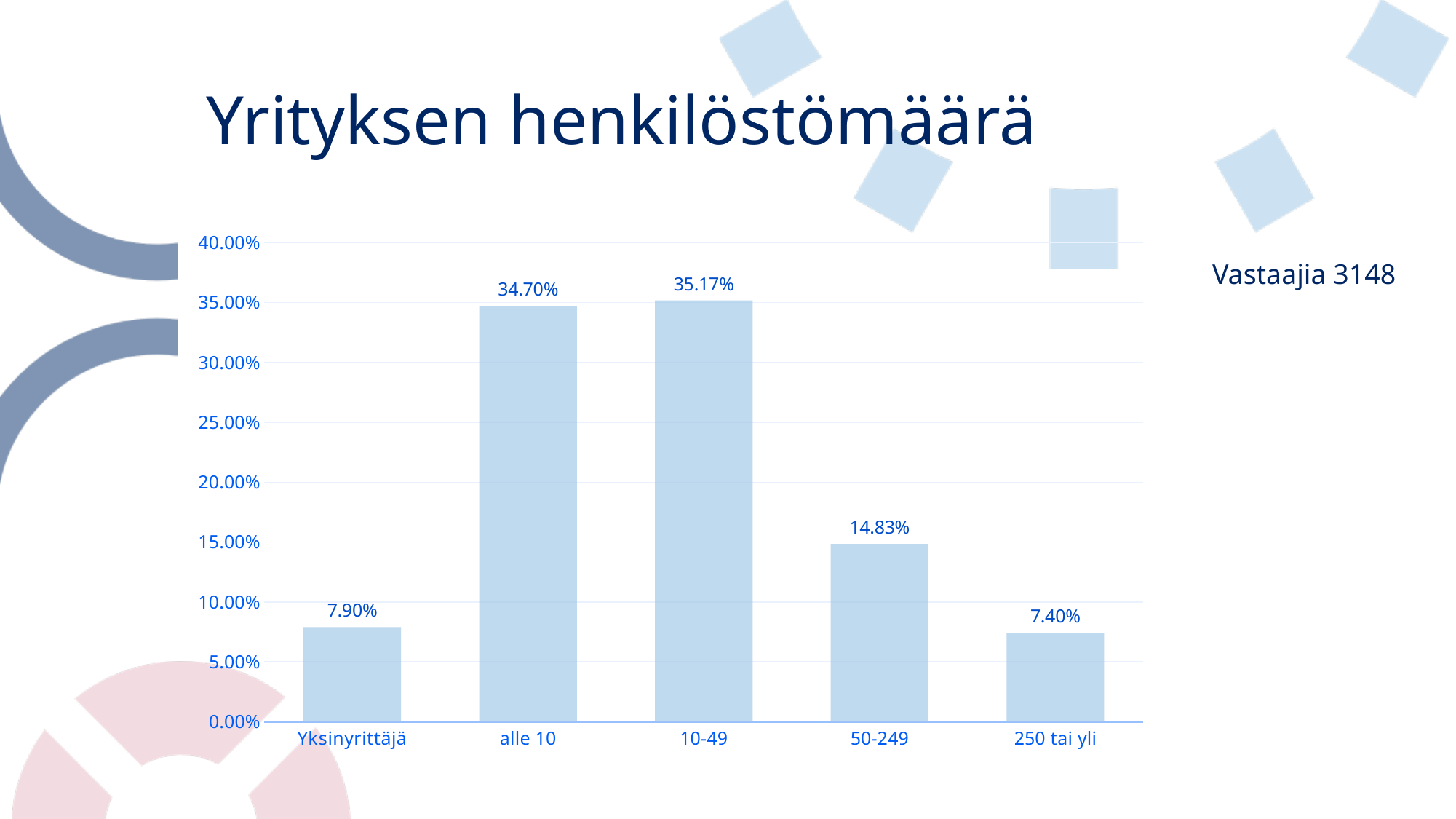
How many categories are shown on the x axis? 5 Is the value for '50-249' greater or less than 10.00%? greater What is the value for '50-249'? 14.83% What is the title of the slide? Yrityksen henkilöstömäärä Which is larger, the value for 'Yksinyrittäjä' or the value for '250 tai yli'? Yksinyrittäjä What is the value for 'alle 10'? 34.70% Which category has the highest value? 10-49 What kind of chart is shown on the slide? bar chart How many respondents (Vastaajia) are stated on the slide? 3148 What is the value for 'Yksinyrittäjä'? 7.90% What is the difference between the values for '10-49' and '50-249'? 20.34% Which category has the lowest value? 250 tai yli